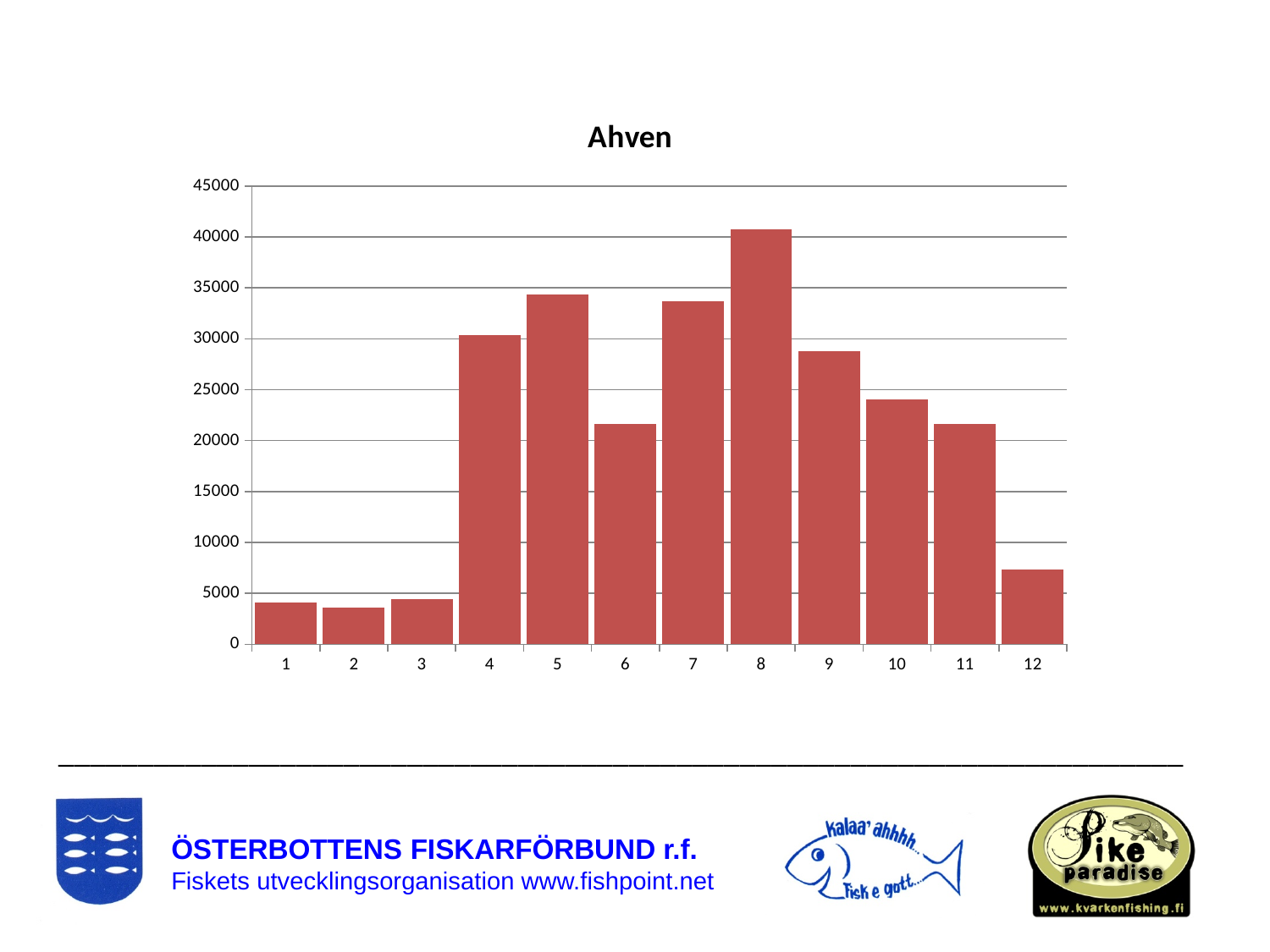
Which category has the lowest value? 2 Is the value for category 8 greater or less than 40000? greater Which has the larger value, category 6 or category 10? 10 What is the title of the chart? Ahven Which category has the highest value? 8 Is the value for category 9 greater or less than 30000? less Is the value for category 10 greater or less than 25000? less Which has the larger value, category 4 or category 9? 4 How many categories are shown on the x axis? 12 What kind of chart is shown on the slide? bar chart